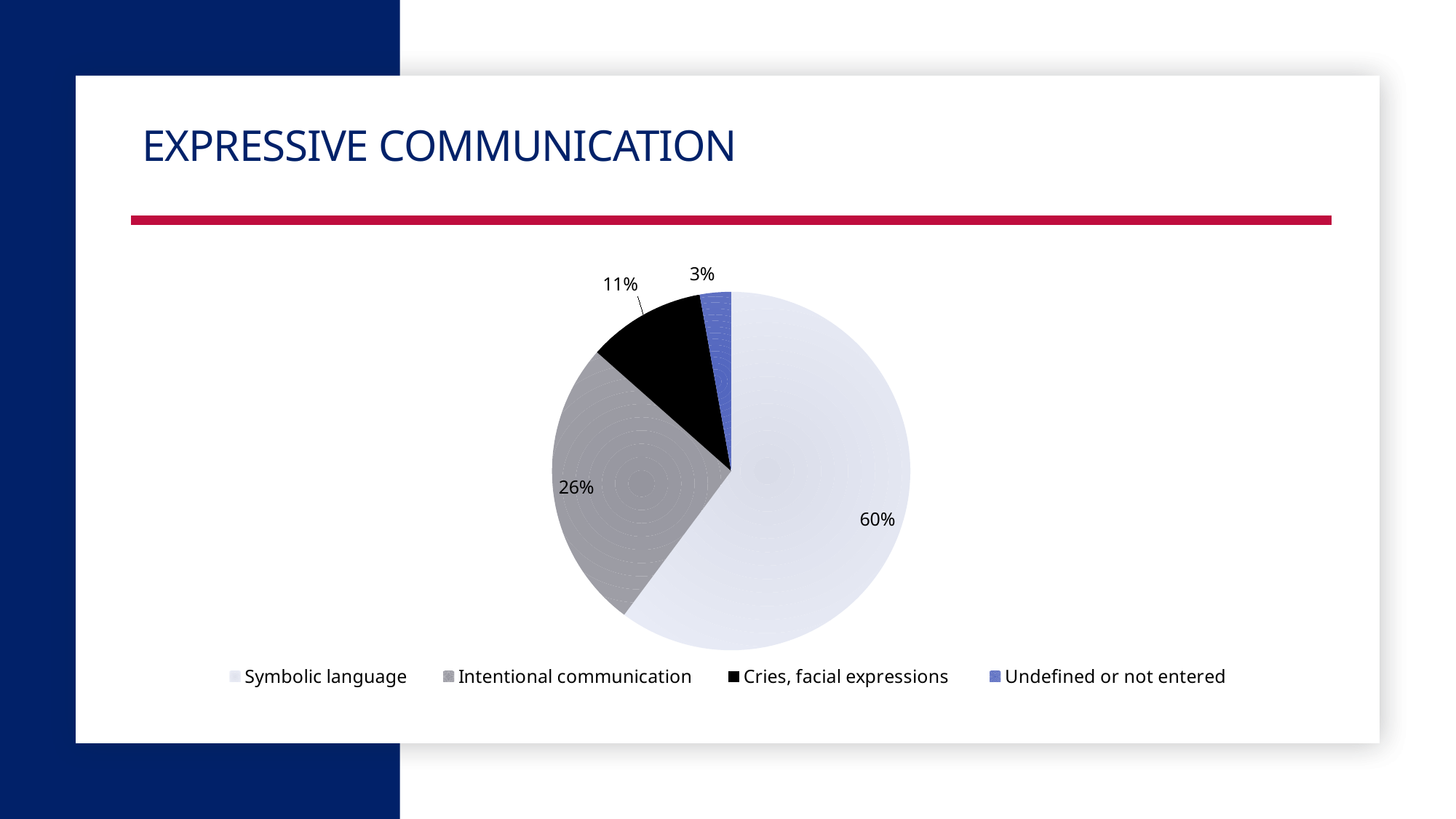
Which is larger, the share for Intentional communication or the share for Cries, facial expressions? Intentional communication Which category is shown in black in the pie chart? Cries, facial expressions What share of the pie is Intentional communication? 26% What is the title of the slide containing the chart? EXPRESSIVE COMMUNICATION What share of the pie is Symbolic language? 60% What share of the pie is Cries, facial expressions? 11% Which category has the largest slice of the pie? Symbolic language What is the difference between the shares for Symbolic language and Intentional communication? 34% Which category has the smallest slice of the pie? Undefined or not entered What kind of chart is shown on the slide? Pie chart How many categories does the pie chart show? 4